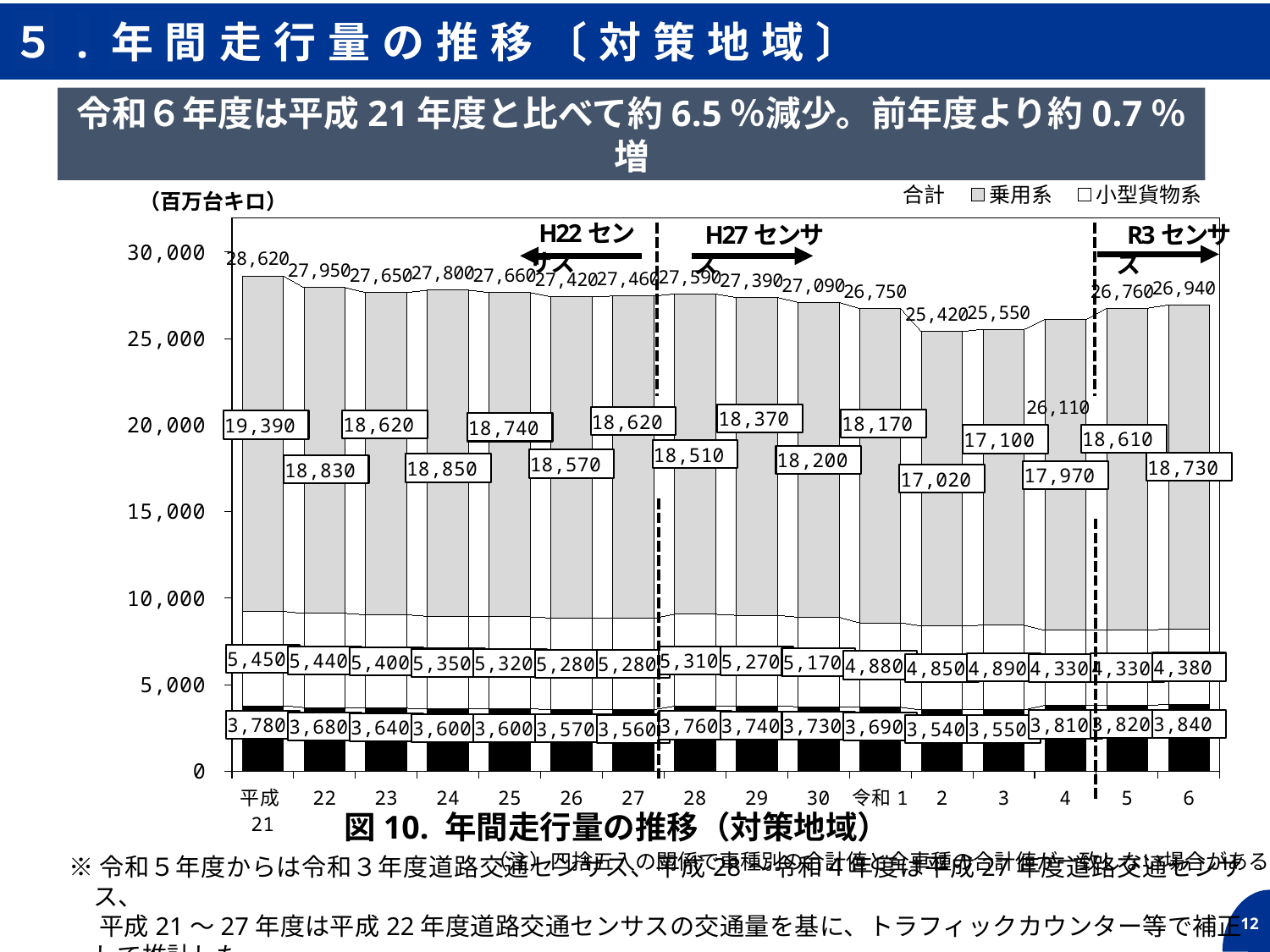
What unit is shown for the values in 図10? 百万台キロ Which is larger in 図10: the 乗用系 value for 平成21 or for 令和6? 平成21 Which fiscal year has the highest total (合計) value in 図10? 平成21 By how much is the total (合計) for 平成21 larger than the total for 令和6 in 図10? 1,680 Which fiscal year has the lowest total (合計) value in 図10? 令和2 What is the 小型貨物系 value for 令和6 in 図10? 4,380 What kind of chart is 図10? Bar chart What is the total (合計) annual travel volume for 令和6 in 図10? 26,940 What is the 乗用系 value for 令和2 in 図10? 17,020 What is the total (合計) annual travel volume for 平成21 in 図10? 28,620 Does the total (合計) value rise or fall from 平成21 to 令和2 in 図10? Fall How many fiscal years are shown on the x axis of 図10? 16